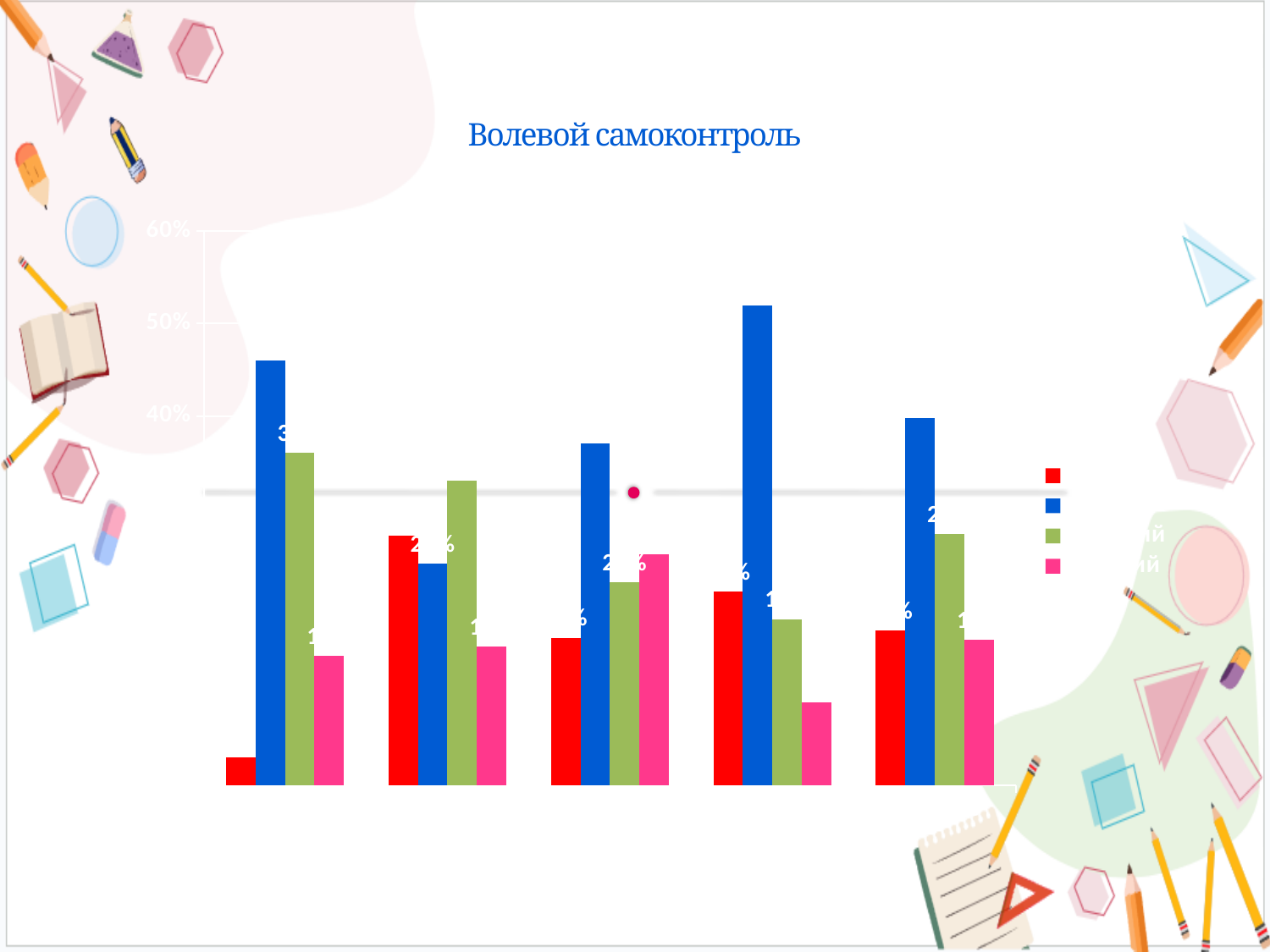
Is the blue bar in the third group from the left greater or less than 40%? less In the first group from the left, which series has the shortest bar? red Is the tallest blue bar (in the fourth group from the left) greater or less than 50%? greater What colours are the four series in the legend, from top to bottom? red, blue, green, pink How many groups of bars are plotted along the x axis? 5 Is the blue bar in the first group from the left greater or less than 50%? less What kind of chart is shown on the slide? bar chart What is the title of the chart? Волевой самоконтроль Which series has the tallest bar on the whole chart? blue How many series does the legend list? 4